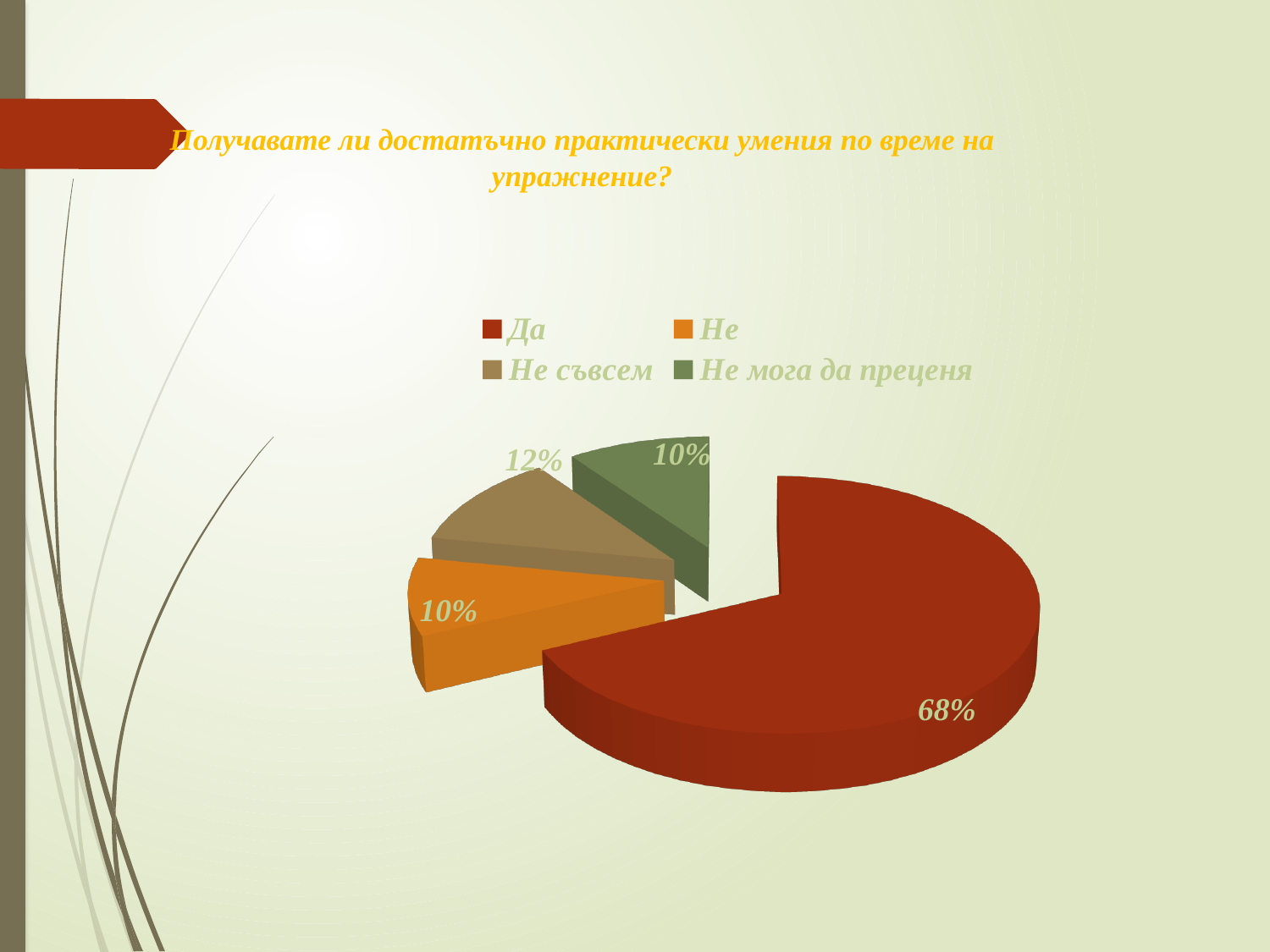
What is the combined share of "Не" and "Не мога да преценя"? 20% How many slices does the pie chart have? 4 How many entries does the legend list? 4 What colour is the slice for "Да"? Red What share of the pie does "Не съвсем" have? 12% Which category has the largest slice of the pie? Да What share of the pie does "Да" have? 68% What share of the pie does "Не мога да преценя" have? 10% What kind of chart is shown on the slide? Pie chart What is the difference in percentage points between "Да" and "Не съвсем"? 56 What share of the pie does "Не" have? 10% Which is larger, the slice for "Не съвсем" or the slice for "Не"? Не съвсем